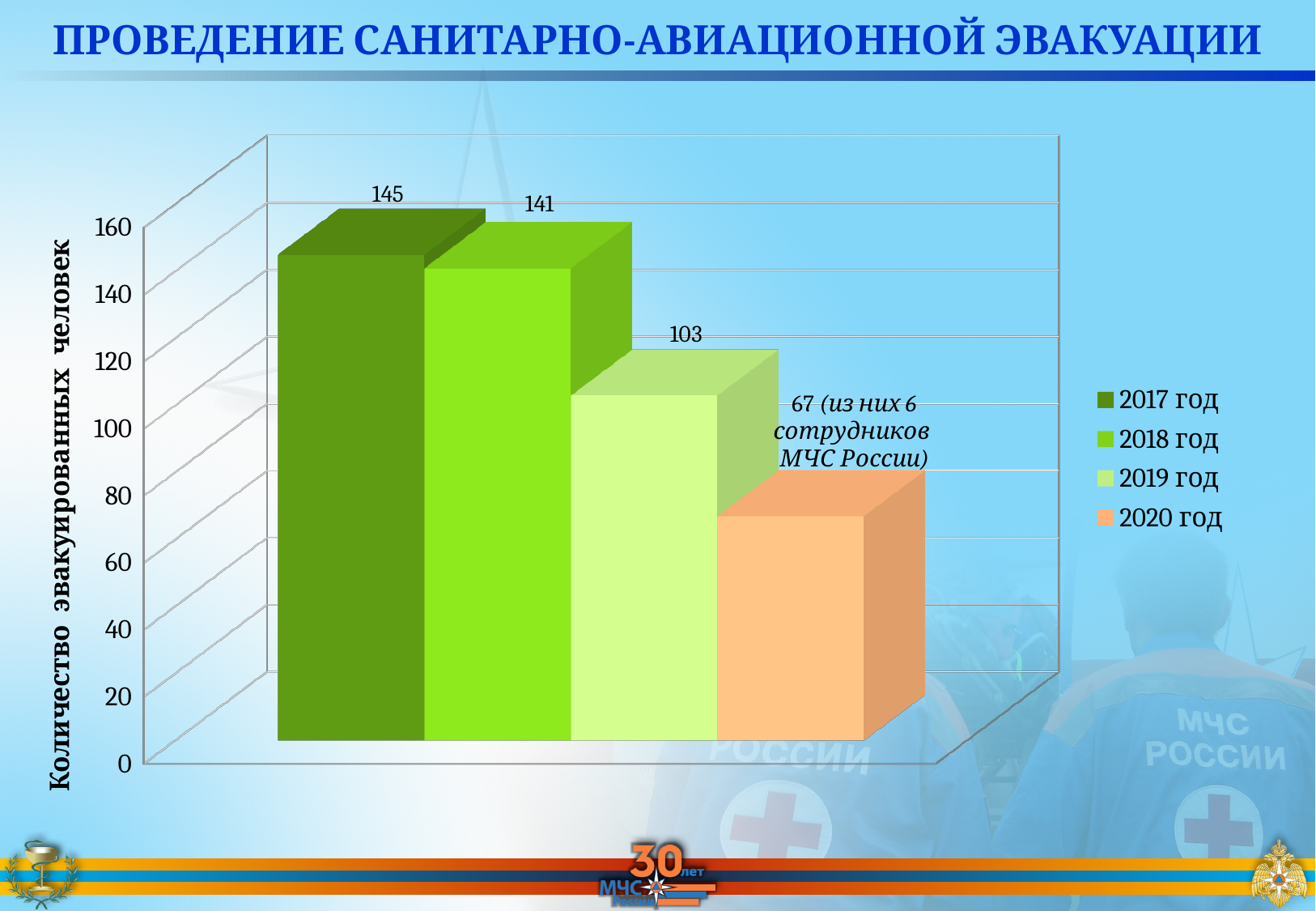
Which year has the lowest value? 2020 год Which year has the highest value? 2017 год Do the values rise or fall from 2017 год to 2020 год? Fall What is the difference between the values for 2017 год and 2020 год? 78 What is the value for 2018 год? 141 What is the value for 2020 год? 67 What is the difference between the values for 2018 год and 2019 год? 38 What kind of chart is shown on the slide? Bar chart Which is larger, the value for 2019 год or the value for 2020 год? 2019 год What is the value for 2017 год? 145 What is the value for 2019 год? 103 How many series does the legend list? 4